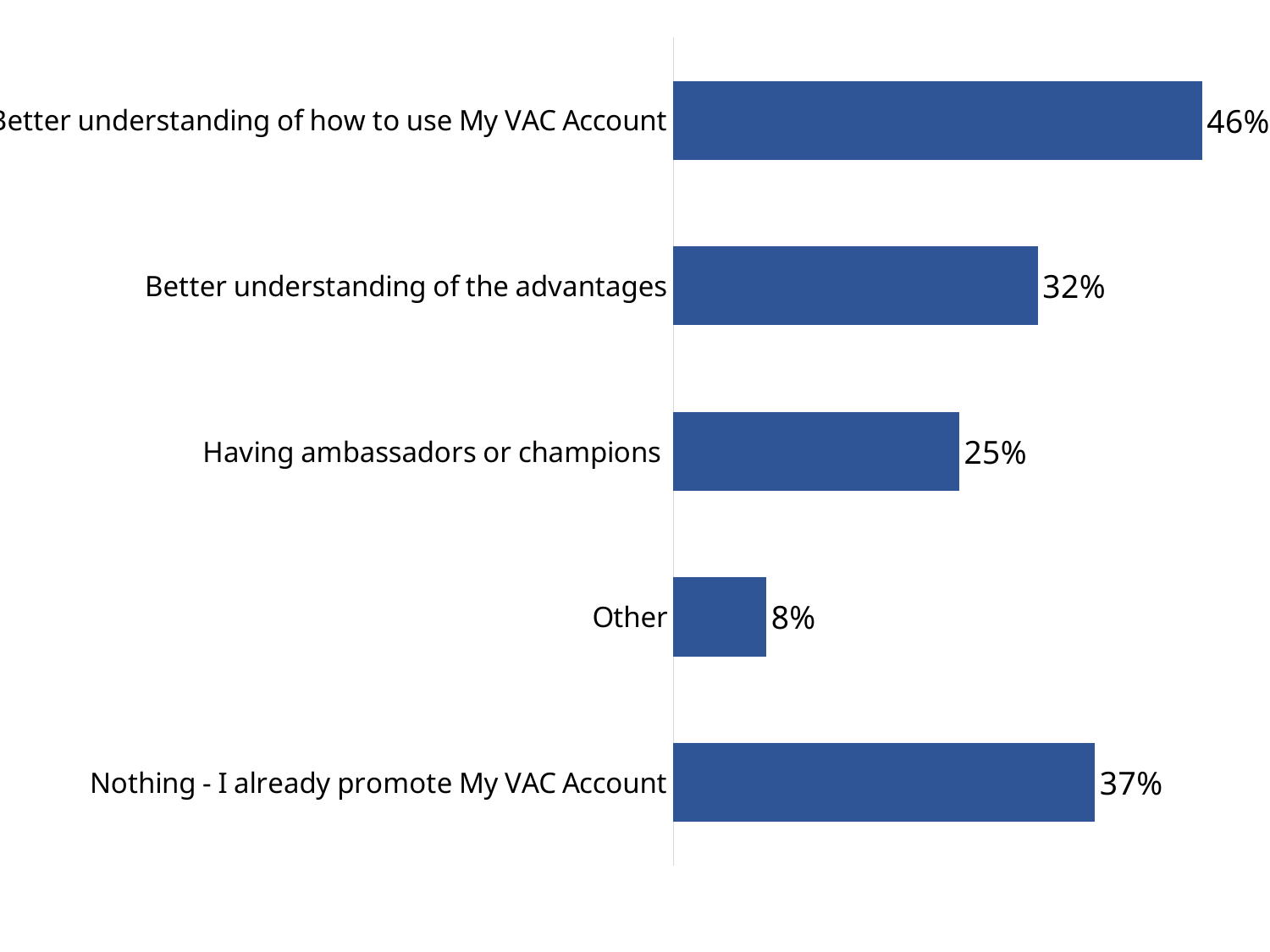
What is the difference between the values for "Better understanding of how to use My VAC Account" and "Nothing - I already promote My VAC Account"? 9% Which is larger: the value for "Nothing - I already promote My VAC Account" or the value for "Better understanding of the advantages"? Nothing - I already promote My VAC Account What is the value for "Other"? 8% What is the value for "Better understanding of the advantages"? 32% What kind of chart is shown on the slide? Bar chart What is the value for "Better understanding of how to use My VAC Account"? 46% Which category has the lowest value? Other What is the value for "Nothing - I already promote My VAC Account"? 37% What is the difference between the values for "Better understanding of the advantages" and "Having ambassadors or champions"? 7% Which category has the highest value? Better understanding of how to use My VAC Account What is the value for "Having ambassadors or champions"? 25% How many categories are shown in the chart? 5